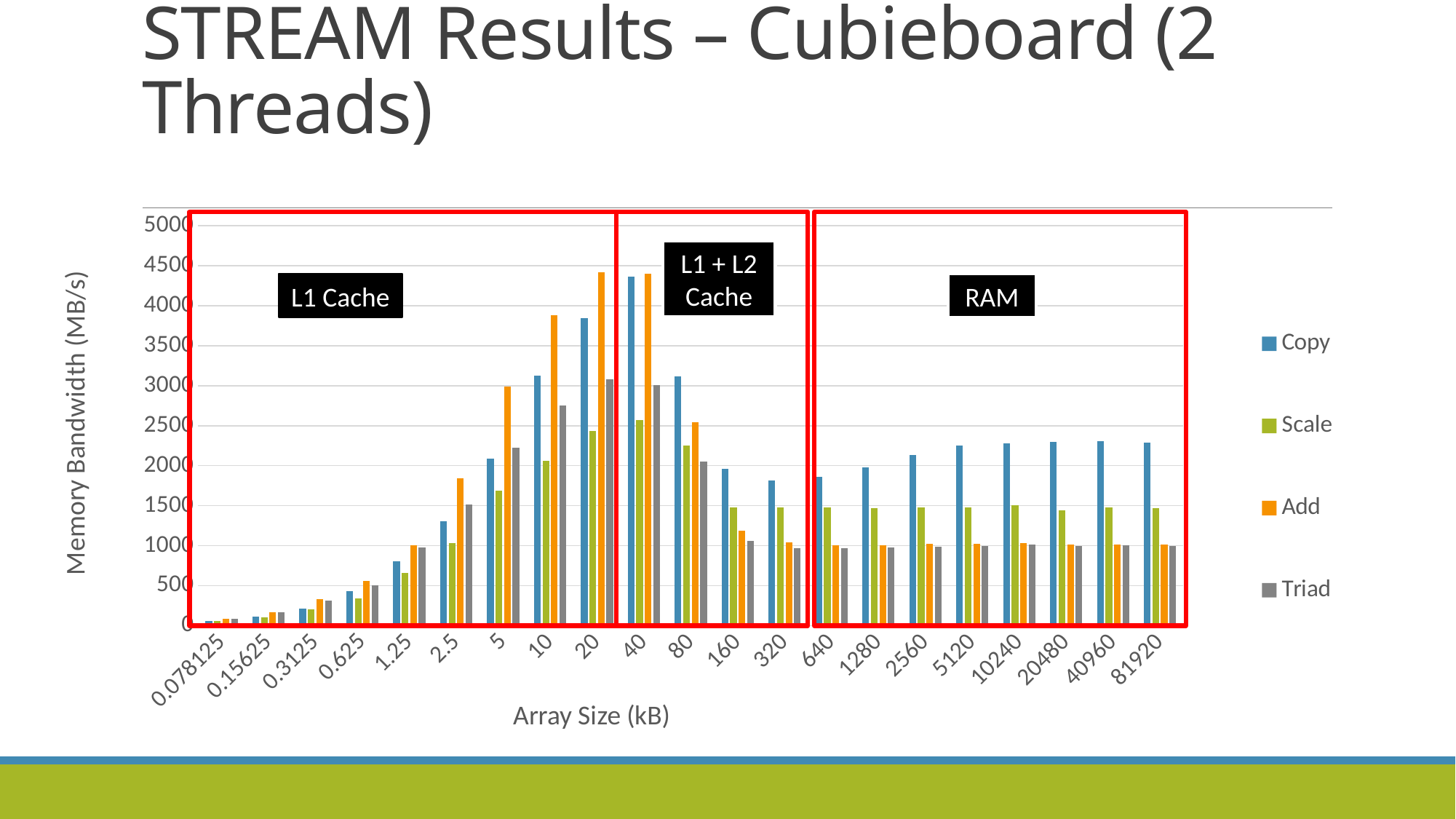
What kind of chart is shown on the slide? bar chart Is the Copy value at array size 80 kB greater or less than 3000 MB/s? greater At array size 20 kB, which is larger, Add or Copy? Add How many array size categories are shown on the x axis? 21 At array size 80 kB, which is larger, Copy or Add? Copy Which series has the highest value at array size 20 kB? Add Is the Add value at array size 20 kB greater or less than 4000 MB/s? greater Which series has the lowest value at array size 40 kB? Scale How many series does the legend list? 4 What label is shown in the black box over the rightmost red region of the chart? RAM Does the Copy series rise or fall from array size 40 kB to 320 kB? fall